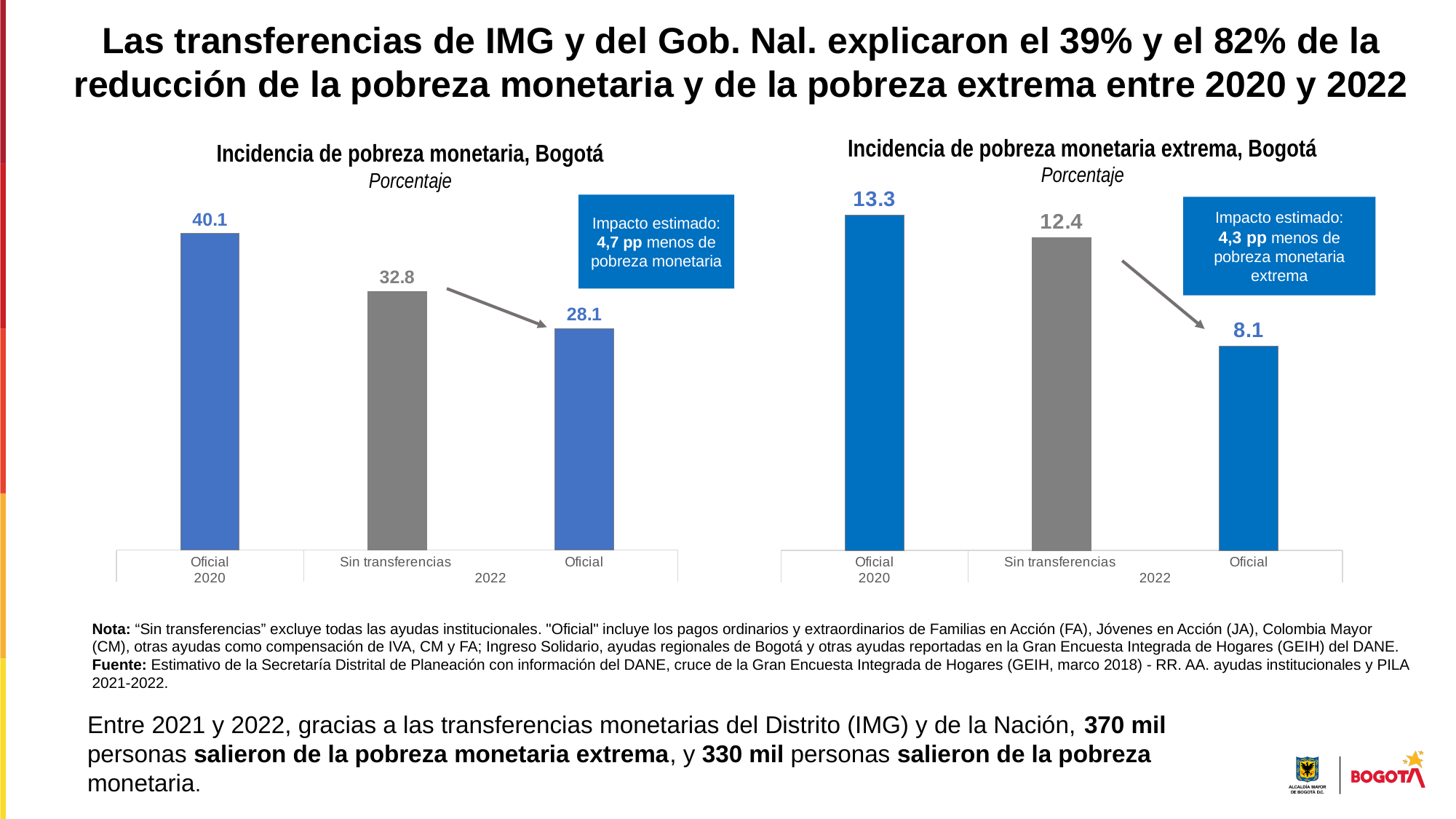
In the chart 'Incidencia de pobreza monetaria extrema, Bogotá', what is the value for Oficial 2022? 8.1 In the chart 'Incidencia de pobreza monetaria, Bogotá', what is the value for Oficial 2020? 40.1 In the chart 'Incidencia de pobreza monetaria extrema, Bogotá', what is the value for Oficial 2020? 13.3 How many bars are shown in the chart 'Incidencia de pobreza monetaria extrema, Bogotá'? 3 In the chart 'Incidencia de pobreza monetaria, Bogotá', which bar has the highest value? Oficial 2020 In the chart 'Incidencia de pobreza monetaria extrema, Bogotá', what is the difference between Oficial 2020 and Oficial 2022? 5.2 In the chart 'Incidencia de pobreza monetaria, Bogotá', what is the value for Oficial 2022? 28.1 In the chart 'Incidencia de pobreza monetaria, Bogotá', what is the difference between Sin transferencias 2022 and Oficial 2022? 4.7 What type of chart is 'Incidencia de pobreza monetaria, Bogotá'? Bar chart In the chart 'Incidencia de pobreza monetaria extrema, Bogotá', what is the value for Sin transferencias 2022? 12.4 In the chart 'Incidencia de pobreza monetaria extrema, Bogotá', which bar has the lowest value? Oficial 2022 In the chart 'Incidencia de pobreza monetaria, Bogotá', what is the value for Sin transferencias 2022? 32.8